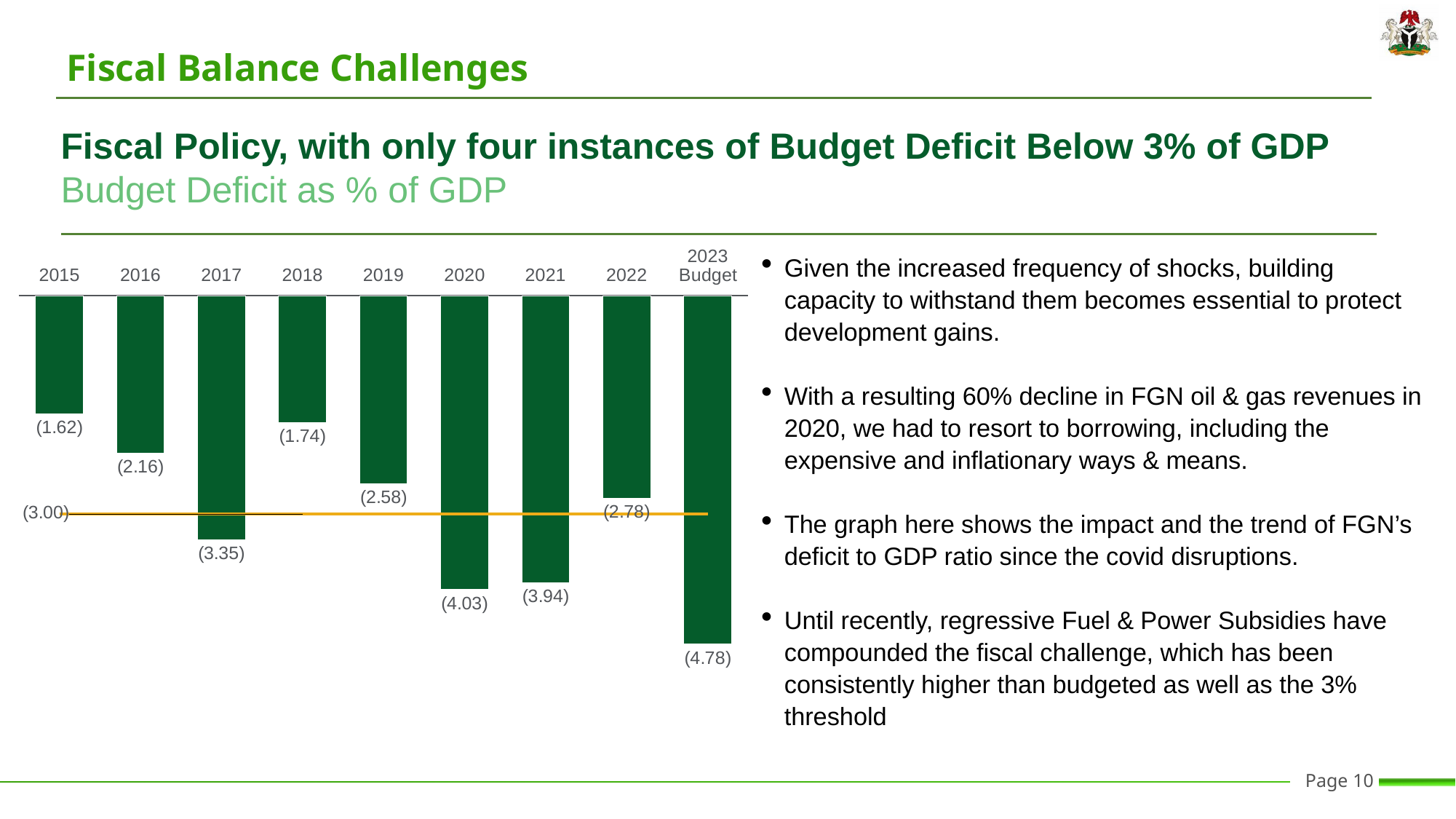
Which year has the smallest budget deficit as % of GDP on the chart? 2015 What is the budget deficit as % of GDP shown for 2015? (1.62) From 2020 to 2022, does the budget deficit as % of GDP increase or decrease? Decrease What kind of chart is used to show the budget deficit as % of GDP? Bar chart How many bars (years) are plotted on the chart? 9 Which year has the largest budget deficit as % of GDP on the chart? 2023 Budget What value is labelled on the bar for 2020? (4.03) What is the value shown for the 2023 Budget bar? (4.78) Which year shows a larger budget deficit, 2017 or 2019? 2017 What value is labelled on the bar for 2017? (3.35) What value is marked by the horizontal threshold line on the chart? (3.00) By how much does the 2023 Budget deficit (4.78) exceed the 2020 deficit (4.03)? 0.75